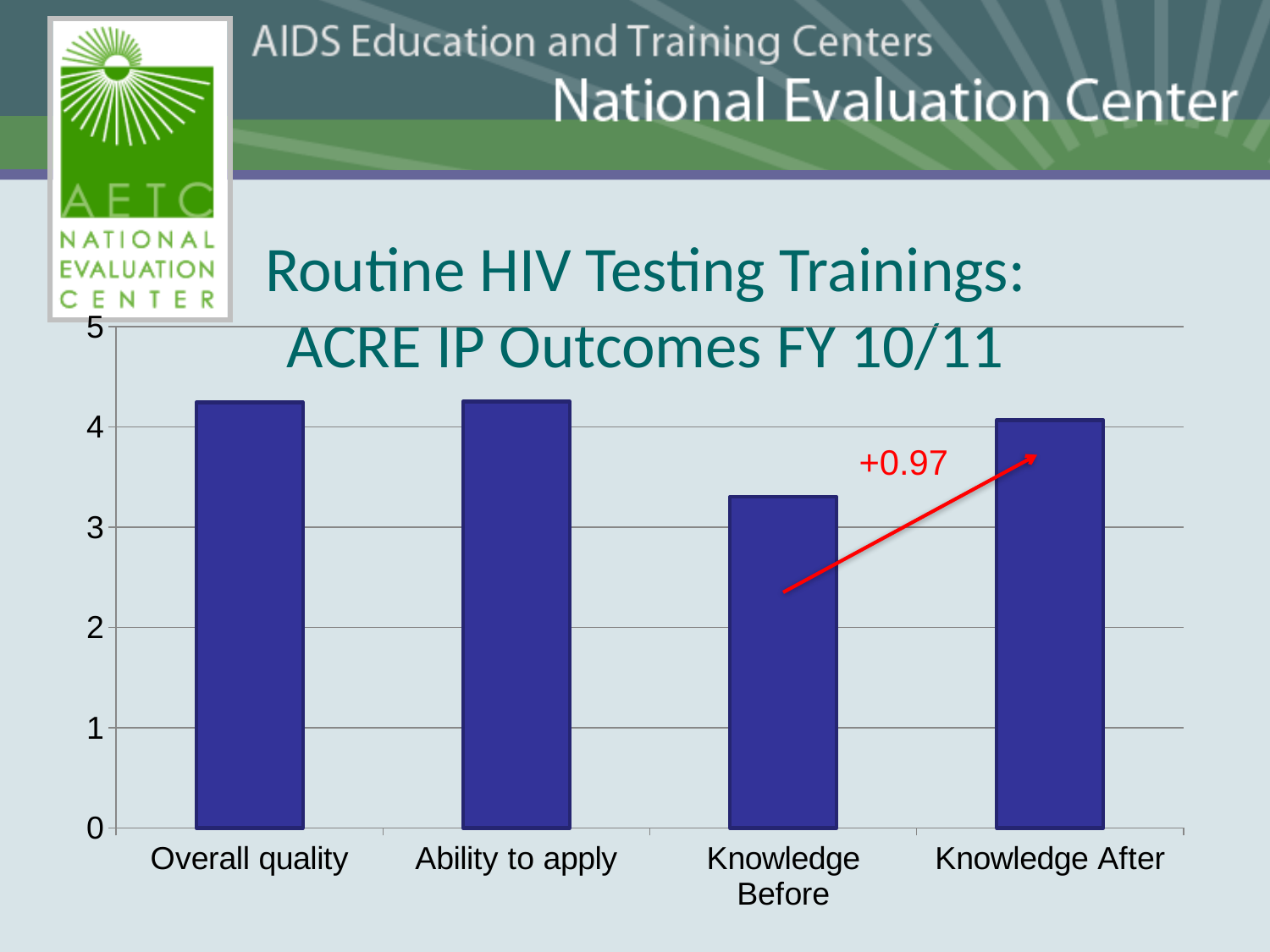
How many categories are shown on the x axis of the chart? 4 Is the value for Overall quality greater or less than 4? greater Is the value for Ability to apply greater or less than 5? less Which is larger, the value for Overall quality or the value for Knowledge Before? Overall quality Which category has the lowest bar in the chart? Knowledge Before What kind of chart is shown on the slide? bar chart Is the value for Knowledge Before greater or less than 4? less Which is larger, the value for Knowledge Before or the value for Knowledge After? Knowledge After What change is indicated by the red arrow annotation between Knowledge Before and Knowledge After? +0.97 What is the title of the chart? Routine HIV Testing Trainings: ACRE IP Outcomes FY 10/11